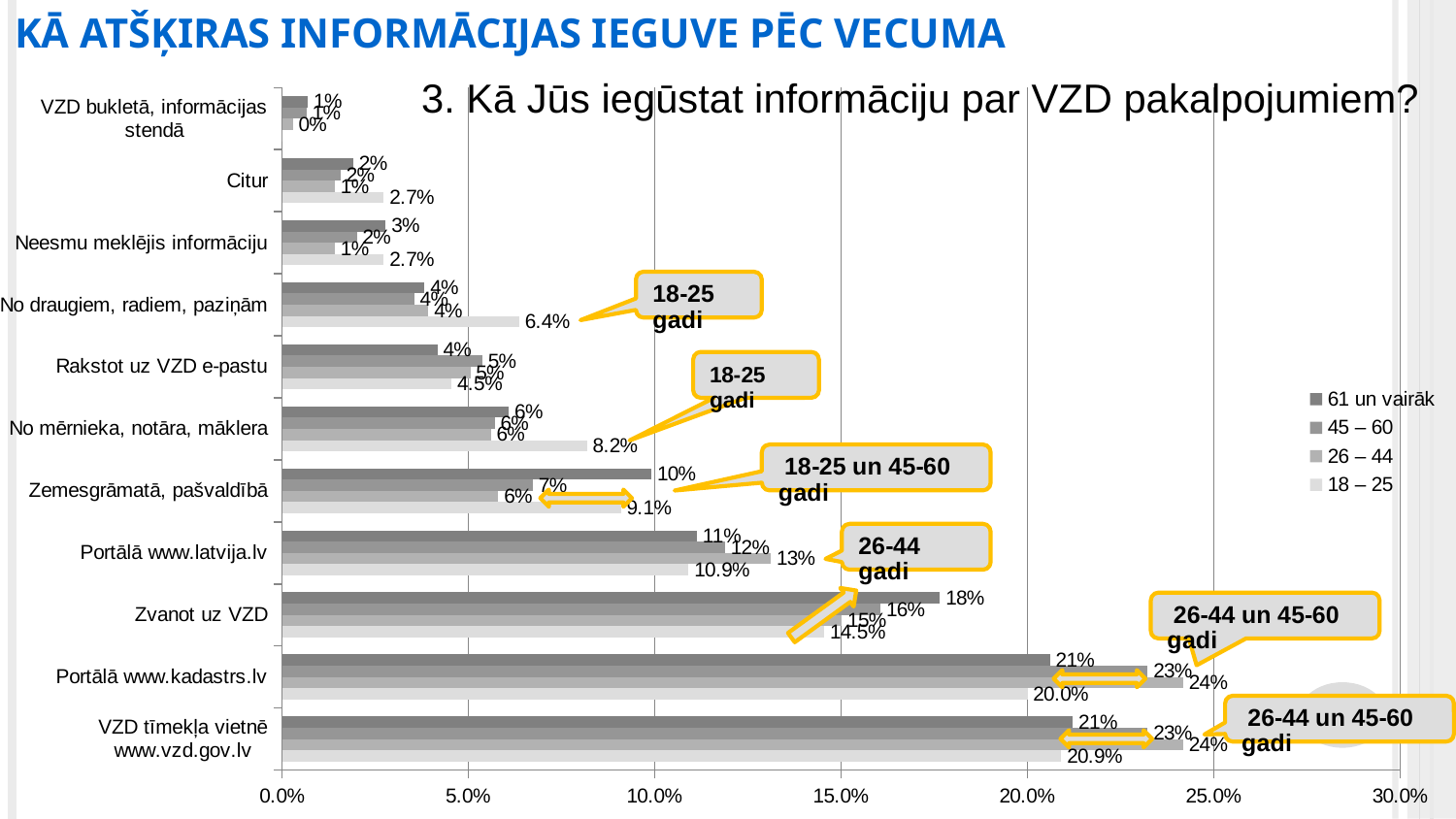
How many series does the legend list? 4 What question is shown as the chart title? 3. Kā Jūs iegūstat informāciju par VZD pakalpojumiem? What is the value for the 18 – 25 series in the category "Zvanot uz VZD"? 14.5% Which category has the lowest values across all series? VZD bukletā, informācijas stendā What is the value for the 18 – 25 series in the category "No mērnieka, notāra, māklera"? 8.2% What kind of chart is shown on the slide? Bar chart Is the value for the 18 – 25 series in "Portālā www.latvija.lv" greater or less than 15.0%? less In the category "Zemesgrāmatā, pašvaldībā", which is larger: the 61 un vairāk value or the 18 – 25 value? 61 un vairāk What is the value for the 18 – 25 series in the category "VZD tīmekļa vietnē www.vzd.gov.lv"? 20.9% What is the value for the 61 un vairāk series in the category "Zvanot uz VZD"? 18% In the category "Zvanot uz VZD", what is the difference between the 61 un vairāk value and the 18 – 25 value? 3.5 percentage points How many categories are shown on the vertical axis of the chart? 11